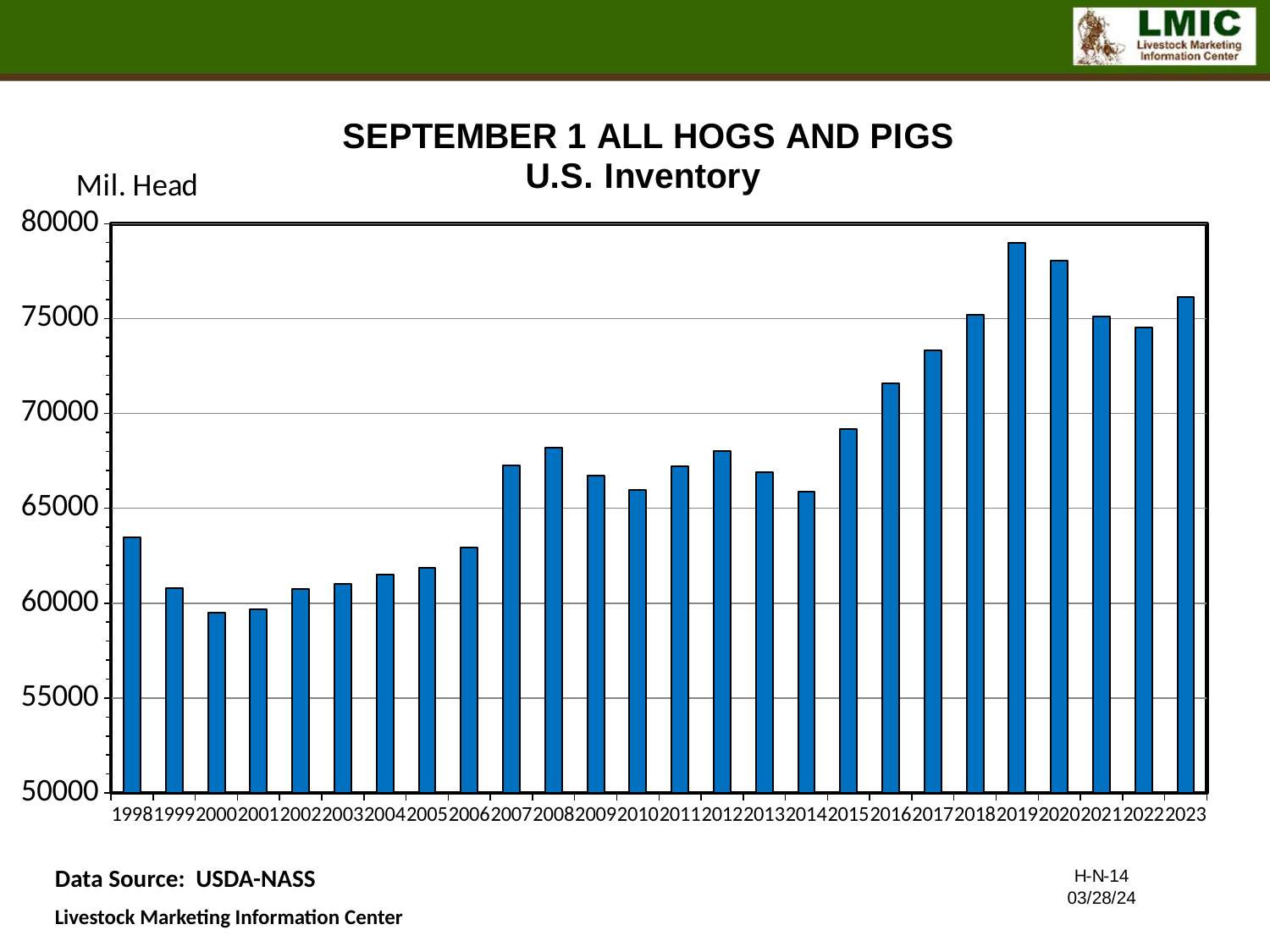
How many years (bars) are plotted in the chart? 26 Is the inventory value for 2000 greater or less than 60000? less Which year has the larger inventory, 2019 or 2020? 2019 Do the inventory values rise or fall from 2014 to 2019? rise Which year has the larger inventory, 2014 or 2015? 2015 Is the inventory value for 2009 greater or less than 70000? less Is the inventory value for 2019 greater or less than 75000? greater What unit label is shown above the vertical axis of the chart? Mil. Head What kind of chart is shown on the slide? bar chart Which year has the highest September 1 all hogs and pigs inventory? 2019